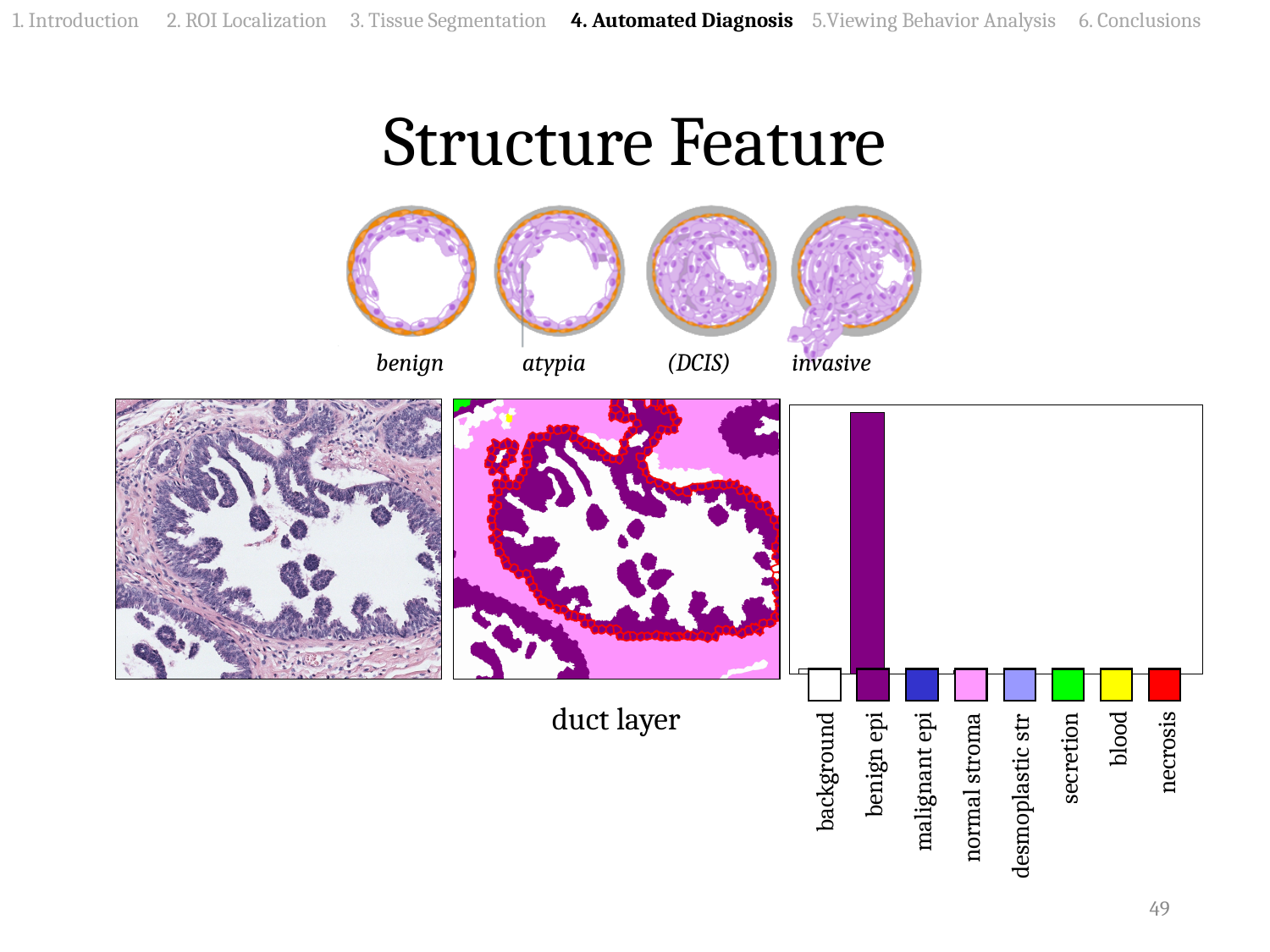
In the bar chart, which is larger, the value for benign epi or the value for normal stroma? benign epi What kind of chart is shown on the right side of the slide? bar chart In the bar chart, which is larger, the value for benign epi or the value for background? benign epi How many categories are shown on the x axis of the bar chart? 8 What colour is the bar for benign epi in the bar chart? purple Which category has the highest bar in the bar chart? benign epi What is the label of the first category on the x axis of the bar chart? background